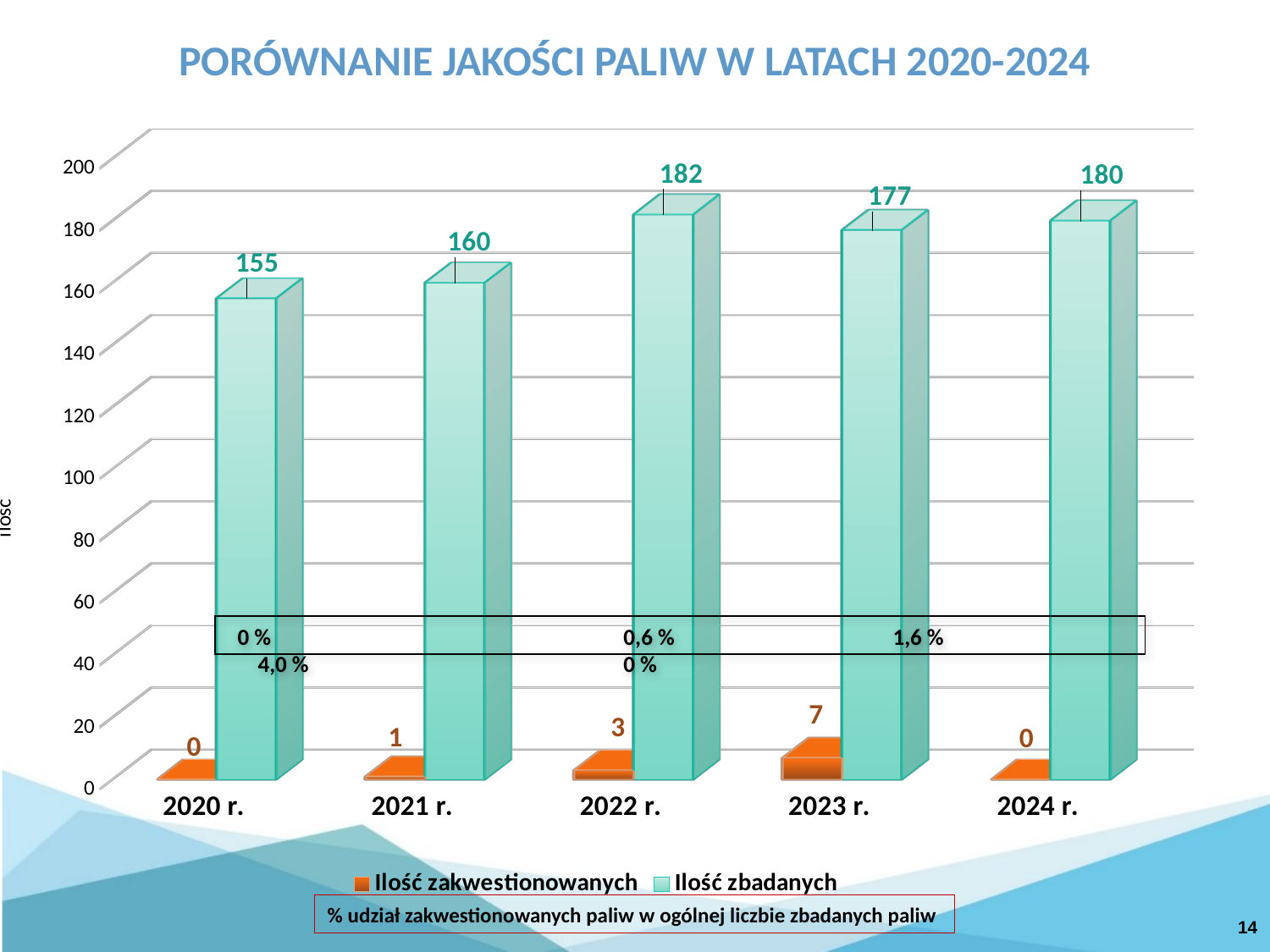
Which year has the lowest value of "Ilość zbadanych"? 2020 r. What kind of chart is shown on the slide? Bar chart What is the title of the chart? PORÓWNANIE JAKOŚCI PALIW W LATACH 2020-2024 How many series does the legend list? 2 Which year has the highest value of "Ilość zbadanych"? 2022 r. Which is larger: "Ilość zbadanych" in 2023 r. or in 2024 r.? 2024 r. What is the value of "Ilość zakwestionowanych" for 2023 r.? 7 What is the value of "Ilość zbadanych" for 2022 r.? 182 What is the difference between "Ilość zbadanych" in 2022 r. and 2020 r.? 27 Which year has the highest value of "Ilość zakwestionowanych"? 2023 r. What is the value of "Ilość zbadanych" for 2020 r.? 155 How many years are shown on the x axis? 5